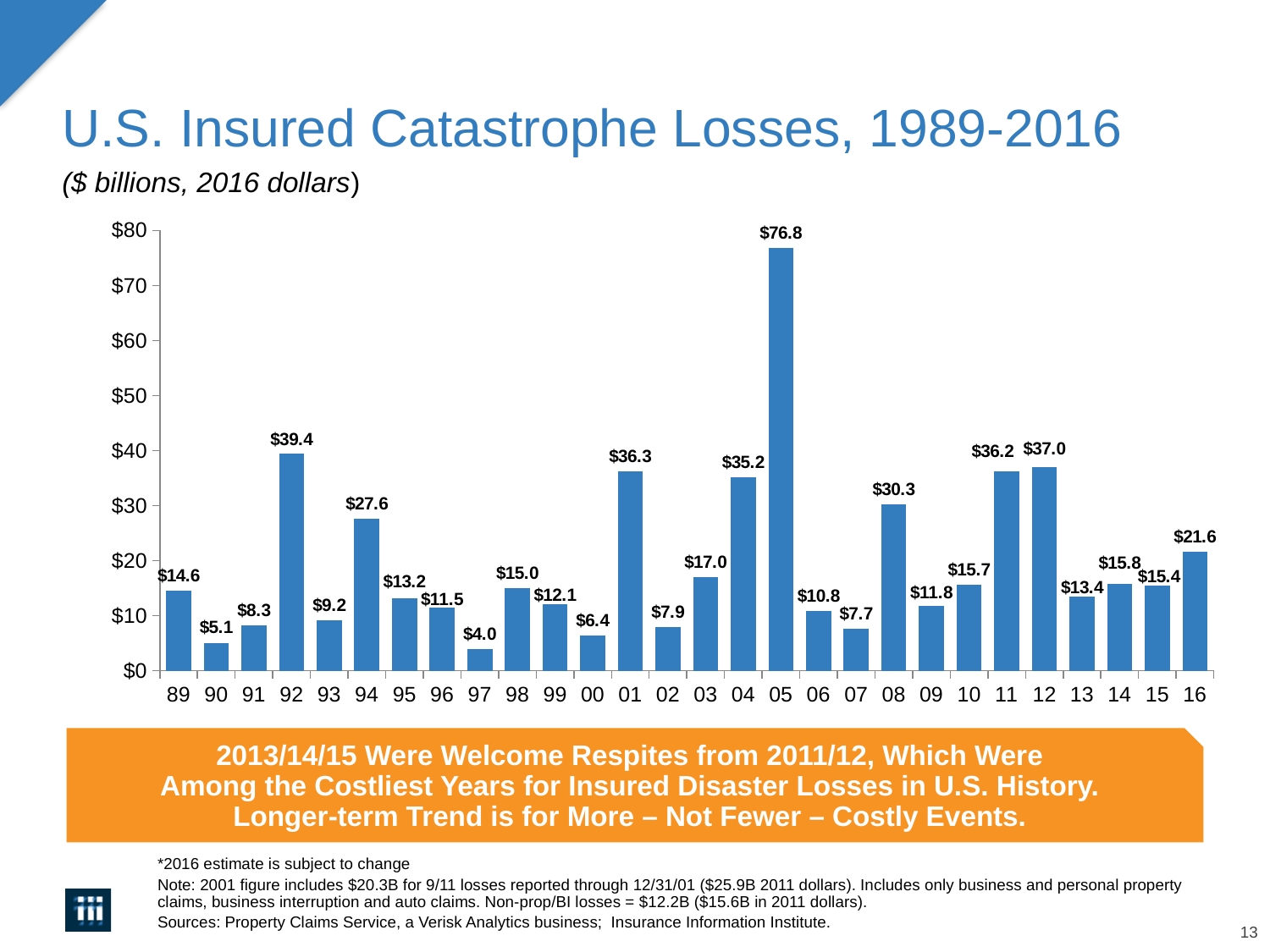
Which is larger, the value for 2004 or the value for 2008? 2004 What is the difference between the values for 2012 and 2011? $0.8 What unit are the values expressed in, according to the subtitle? $ billions, 2016 dollars What is the value for 2016? $21.6 What is the value for 2005? $76.8 Which year has the highest insured catastrophe losses? 05 How many years are shown on the x axis? 28 What is the value for 1992? $39.4 Is the value for 2001 greater or less than $30? greater What is the difference between the values for 2005 and 2001? $40.5 Which year has the lowest insured catastrophe losses? 97 What kind of chart is this? bar chart